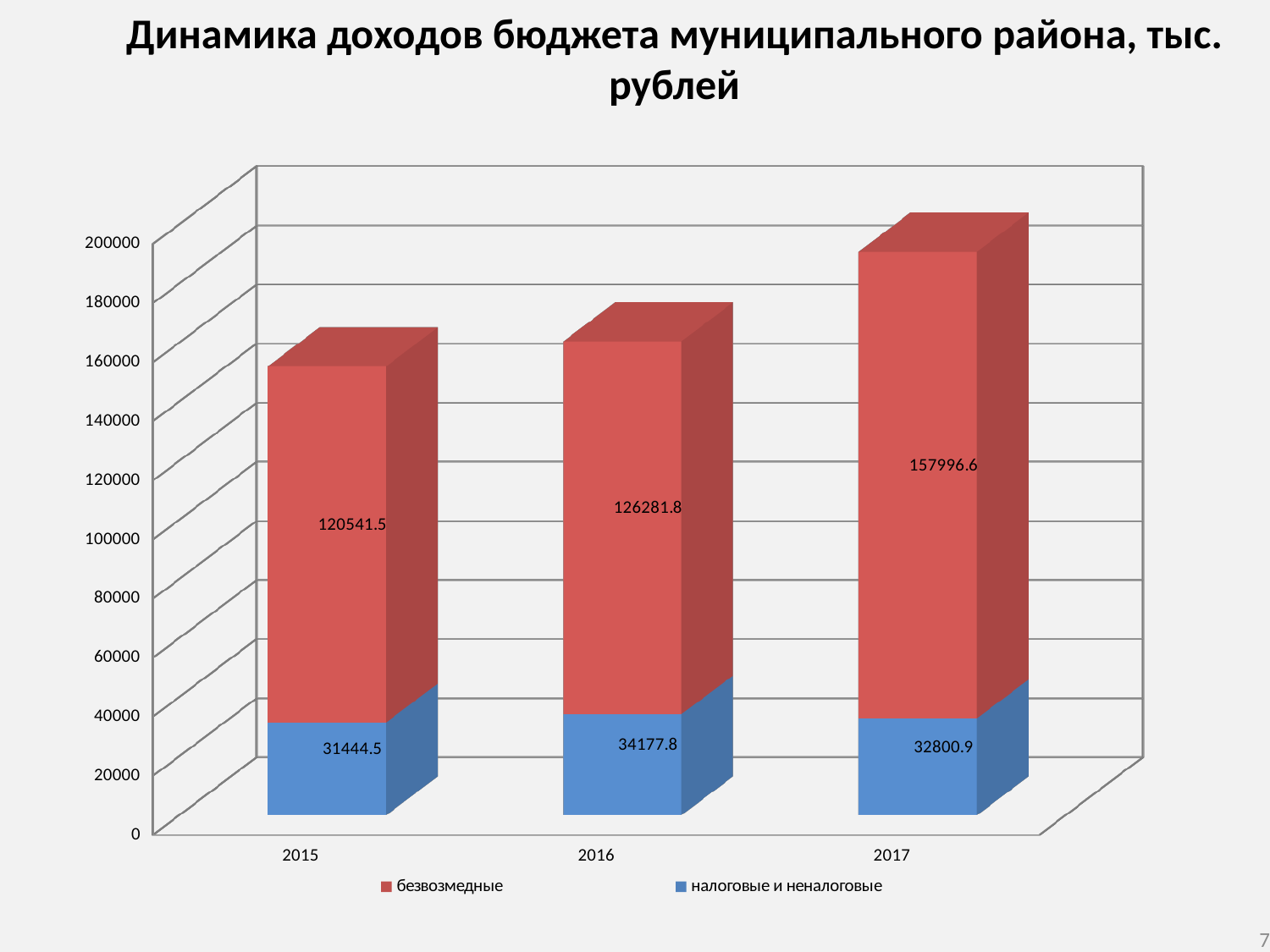
In which year is the value for безвозмедные the highest? 2017 What is the value for налоговые и неналоговые in 2016? 34177.8 In which year is the value for налоговые и неналоговые the lowest? 2015 What is the difference between the безвозмедные values for 2017 and 2016? 31714.8 What is the total of the stacked bar for 2015? 151986.0 What is the value for безвозмедные in 2015? 120541.5 What is the value for безвозмедные in 2017? 157996.6 How many years are shown on the x axis? 3 Which is larger: налоговые и неналоговые in 2016 or in 2017? 2016 How many series does the legend list? 2 What kind of chart is shown on the slide? Stacked bar chart What is the total of the stacked bar for 2017? 190797.5